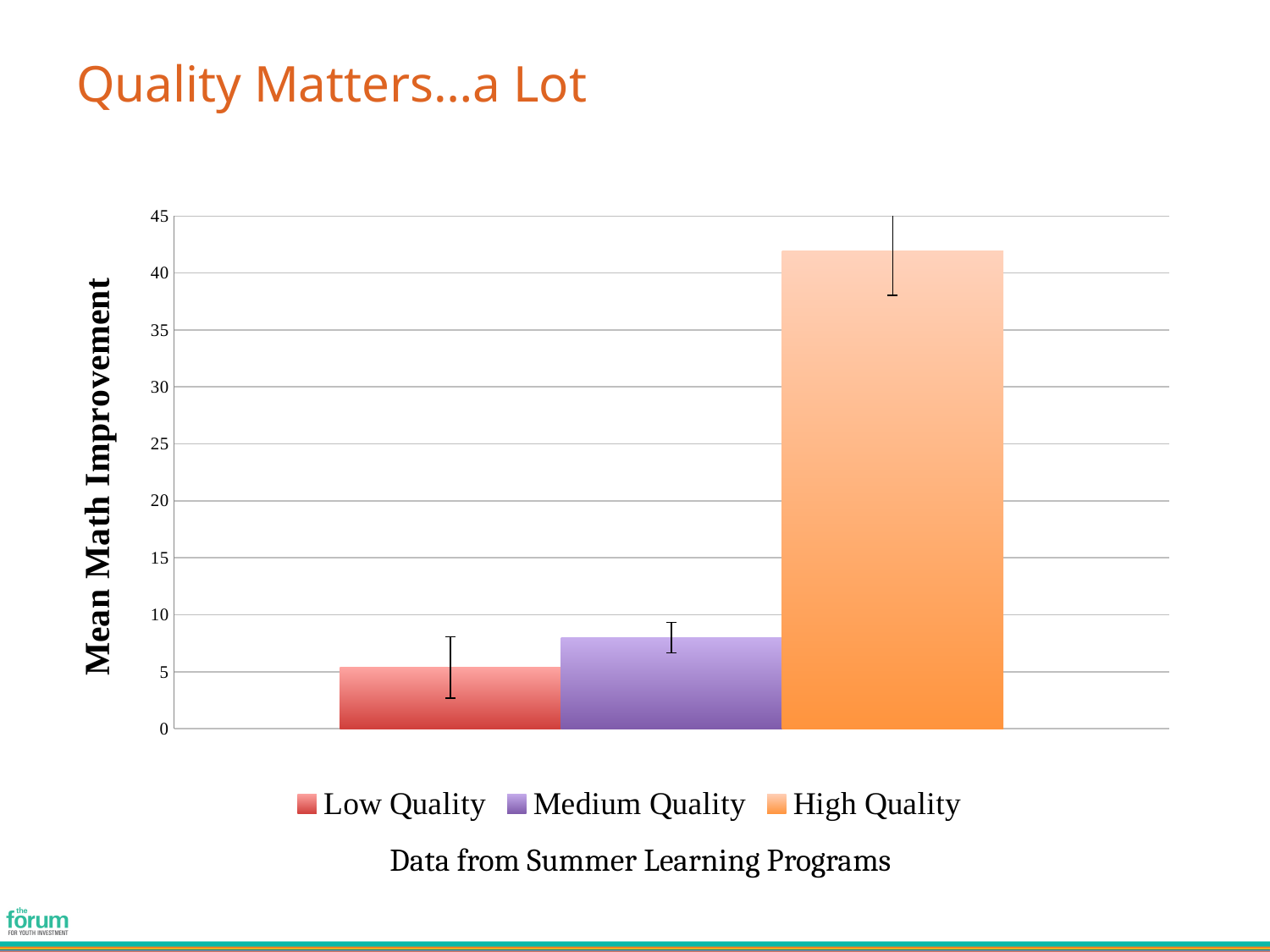
Which is larger, the value for Medium Quality or the value for Low Quality? Medium Quality Is the value for Medium Quality greater or less than 10? less Which quality level has the lowest mean math improvement? Low Quality What colour is the High Quality bar? orange Is the value for High Quality greater or less than 35? greater What is the label on the vertical axis of the chart? Mean Math Improvement Which quality level has the highest mean math improvement? High Quality How many series does the legend list? 3 What kind of chart is shown on the slide? bar chart Is the value for Low Quality greater or less than 10? less